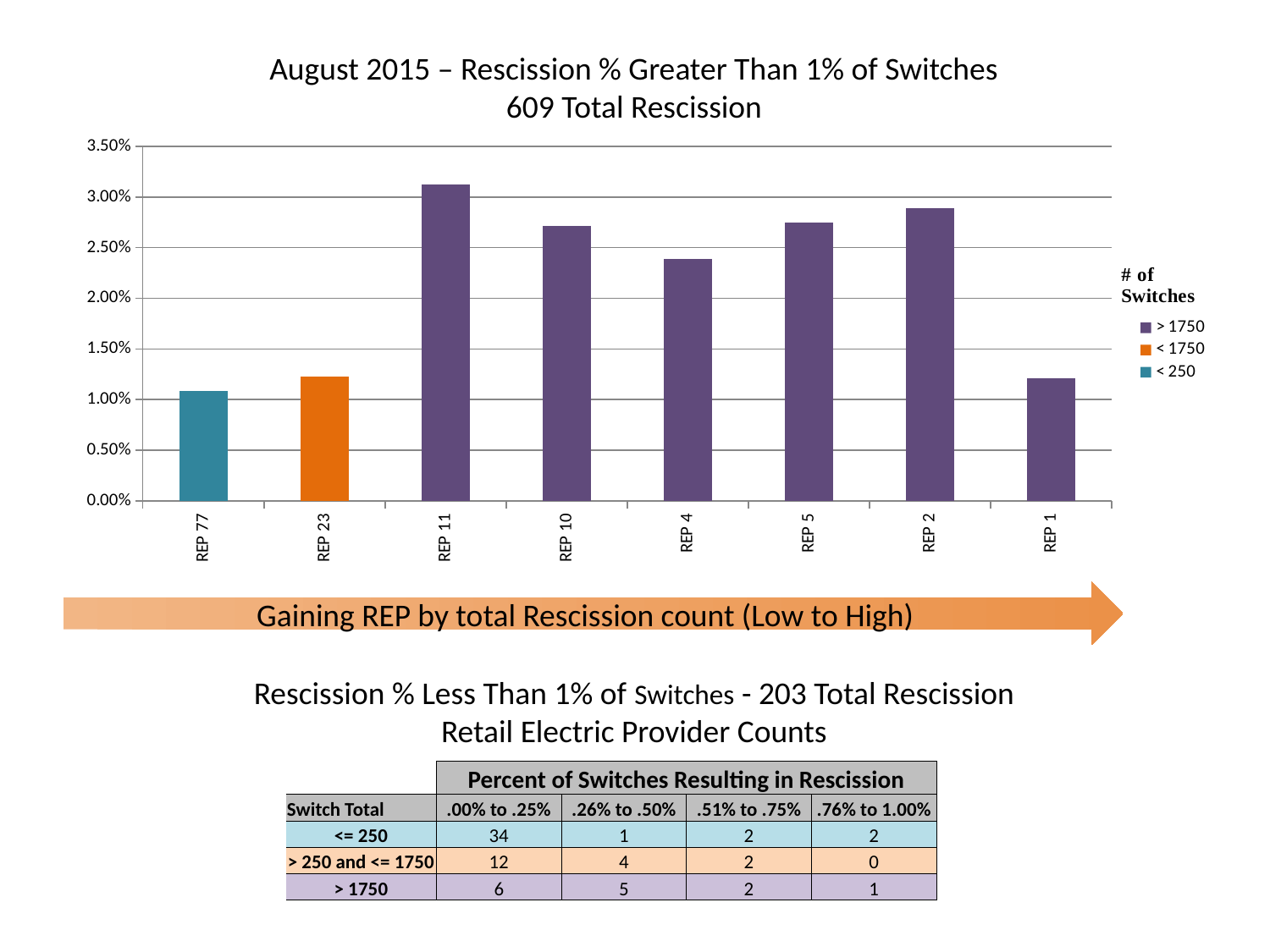
How many REPs are plotted on the x axis of the chart? 8 Is the value for REP 10 greater or less than 2.50%? greater Is the value for REP 4 greater or less than 2.50%? less Is the value for REP 1 greater or less than 1.50%? less According to the legend, which '# of Switches' group does the REP 77 bar belong to? < 250 Which REP has the highest rescission percentage in the chart? REP 11 Which REP has the lowest rescission percentage in the chart? REP 77 Which has the higher rescission percentage, REP 4 or REP 5? REP 5 Which has the higher rescission percentage, REP 11 or REP 10? REP 11 What kind of chart is shown on the slide? bar chart How many series does the chart's legend list? 3